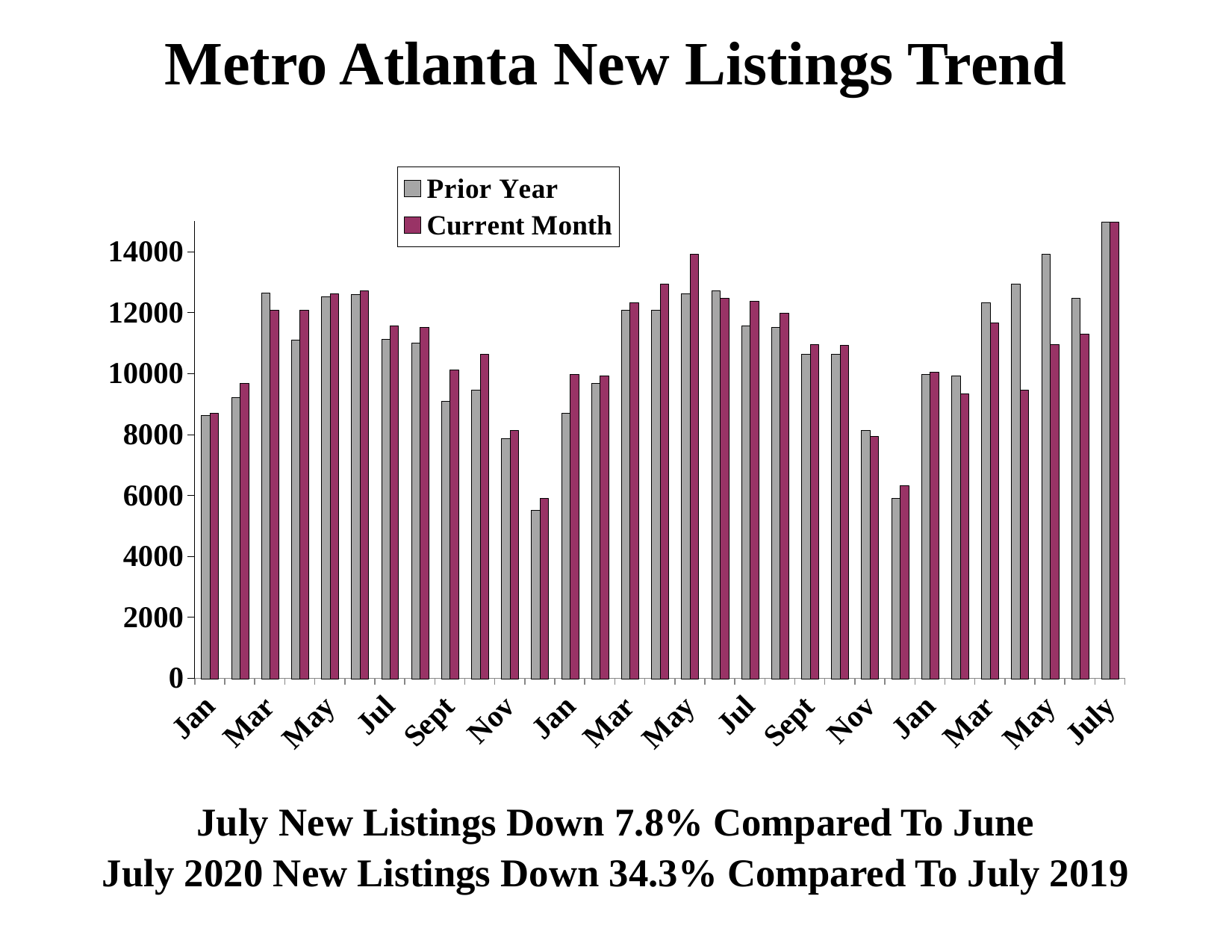
At the third May on the x axis, which series has the larger value, Prior Year or Current Month? Prior Year According to the text below the chart, by what percentage were July 2020 new listings down compared to July 2019? 34.3% How many series does the legend list? 2 Is the Current Month value for the first Jan on the x axis greater or less than 8000? greater Is the Prior Year value for the second Jan on the x axis greater or less than 6000? greater Is the Prior Year value for the final July (rightmost pair of bars) greater or less than 14000? greater Between the second Jan and the second May on the x axis, do the Prior Year values generally rise or fall? rise At the second May on the x axis, which series has the larger value, Prior Year or Current Month? Current Month How many labels are shown along the x axis of the chart? 16 What is the title of the chart? Metro Atlanta New Listings Trend What kind of chart is shown on the slide? bar chart